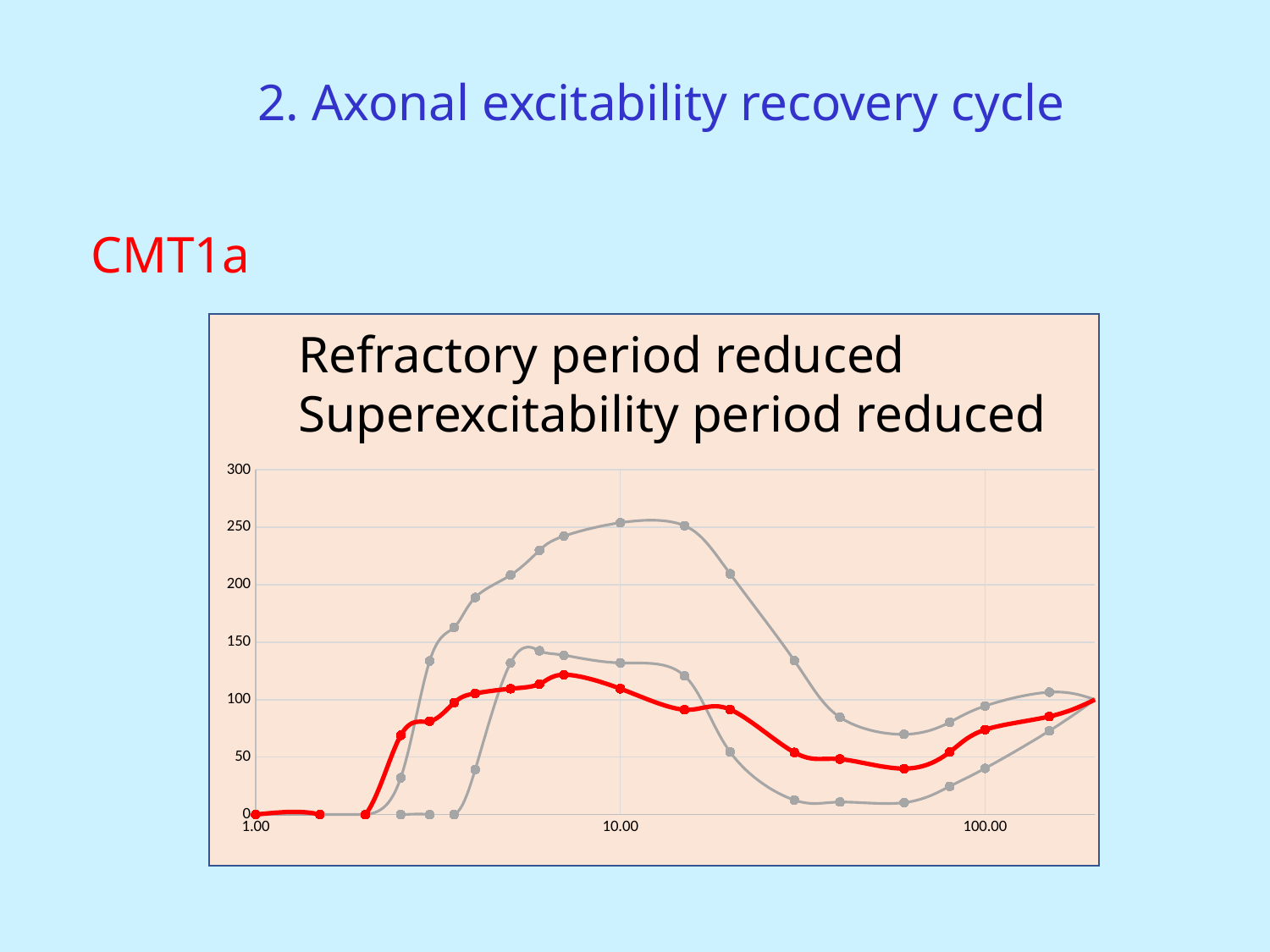
How many lines are plotted on the chart? 3 What kind of chart is shown on the slide? line chart Is the lowest value of the lower grey line in its dip between 10.00 and 100.00 greater or less than 50? less Is the peak value of the red line greater or less than 100? greater Does the red line rise or fall between x = 1.00 and its peak near x = 7? rise Is the peak value of the red line greater or less than 150? less What is the highest value shown on the vertical axis of the chart? 300 Does the red line rise or fall between x = 10.00 and x = 50? fall Which line reaches the highest peak on the chart: the red line or the upper grey line? the upper grey line What text is written inside the chart area above the plot? Refractory period reduced Superexcitability period reduced